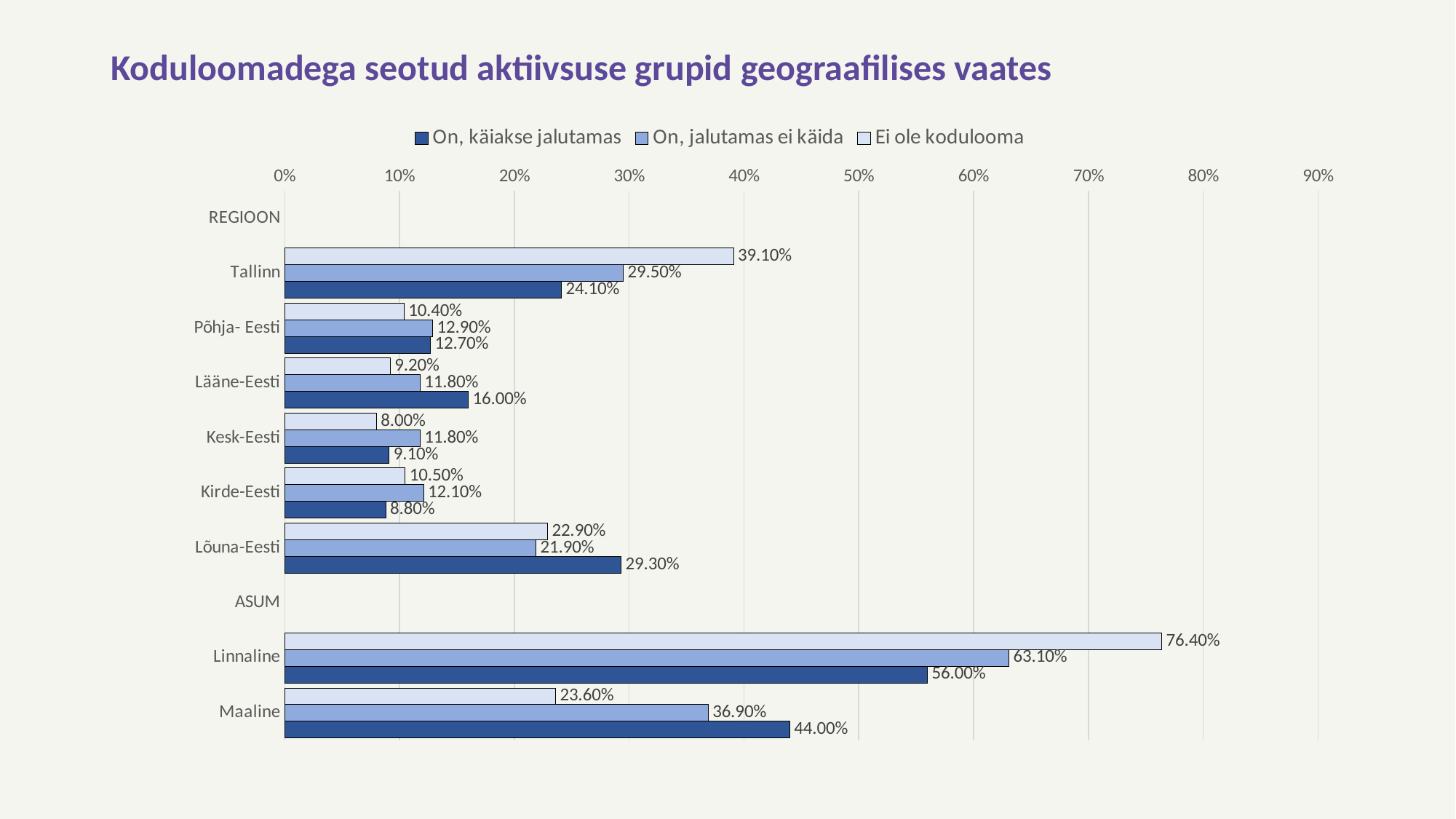
What is the difference between the 'On, käiakse jalutamas' value for Lääne-Eesti and the 'On, käiakse jalutamas' value for Kesk-Eesti? 6.90% What kind of chart is shown on the slide? Bar chart What is the title of the chart? Koduloomadega seotud aktiivsuse grupid geograafilises vaates Which is larger for Maaline: the 'On, käiakse jalutamas' value or the 'Ei ole kodulooma' value? On, käiakse jalutamas What is the difference between the 'Ei ole kodulooma' value for Linnaline and the 'On, käiakse jalutamas' value for Linnaline? 20.40% What is the value for Lõuna-Eesti in the 'On, käiakse jalutamas' series? 29.30% Which category has the highest value in the 'Ei ole kodulooma' series? Linnaline What is the value for Tallinn in the 'Ei ole kodulooma' series? 39.10% How many series does the legend list? 3 Is the 'On, jalutamas ei käida' value for Linnaline greater or less than 60%? greater Which region among Tallinn, Põhja-Eesti, Lääne-Eesti, Kesk-Eesti, Kirde-Eesti and Lõuna-Eesti has the lowest value in the 'Ei ole kodulooma' series? Kesk-Eesti What is the value for Maaline in the 'On, jalutamas ei käida' series? 36.90%